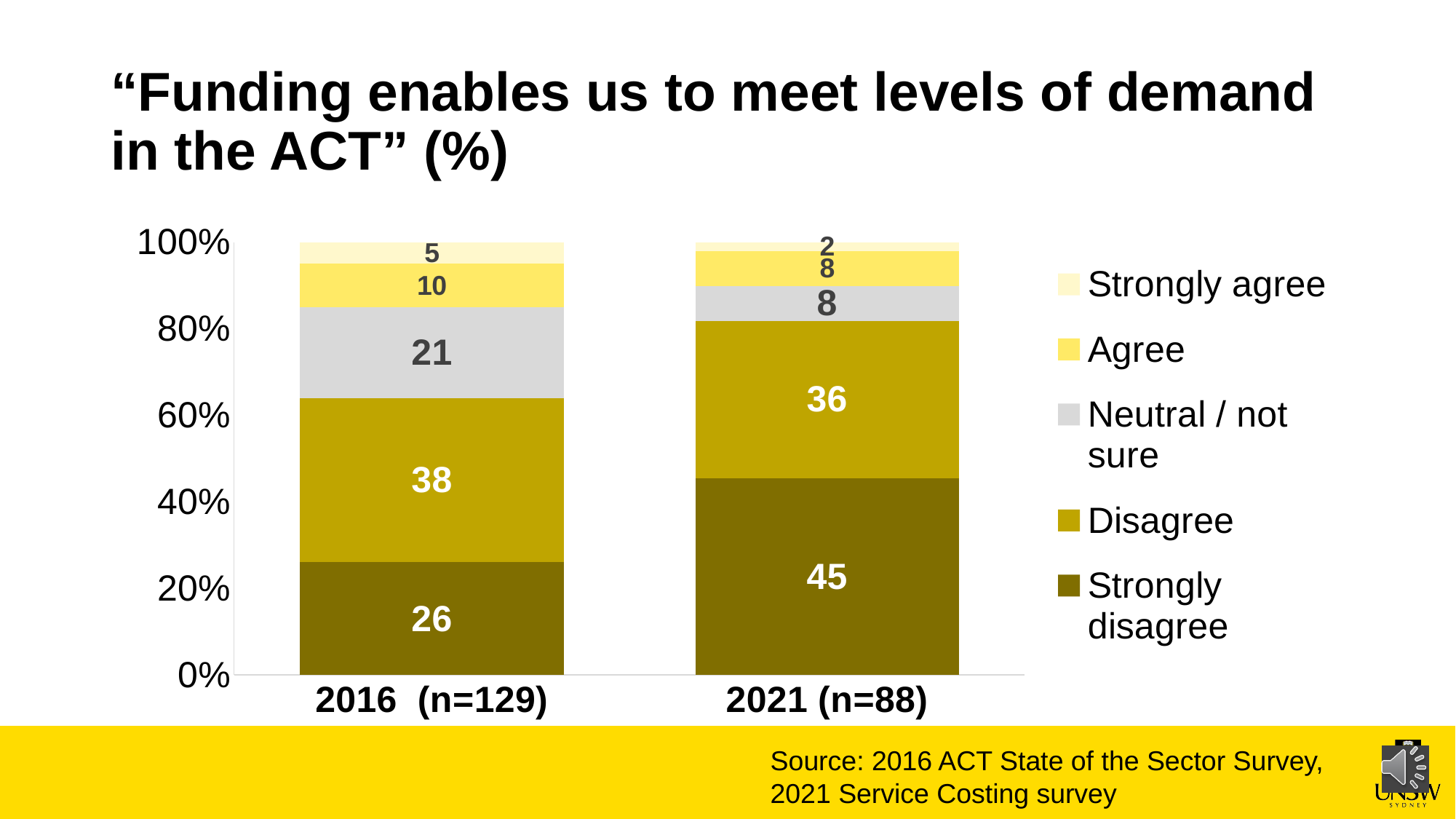
By how much did the Strongly disagree share change from 2016 to 2021? 19 What is the combined share of Agree and Strongly agree in 2016 (n=129)? 15 What kind of chart is shown on the slide? Stacked bar chart What is the value for Agree in 2016 (n=129)? 10 What is the value for Neutral / not sure in 2016 (n=129)? 21 What percentage of respondents strongly disagreed in 2016 (n=129)? 26 What percentage of respondents strongly disagreed in 2021 (n=88)? 45 What is the value for Strongly agree in 2021 (n=88)? 2 Which year has the larger Neutral / not sure share, 2016 or 2021? 2016 How many series does the legend list? 5 Which response category has the largest share in 2021 (n=88)? Strongly disagree Which response category has the largest share in 2016 (n=129)? Disagree